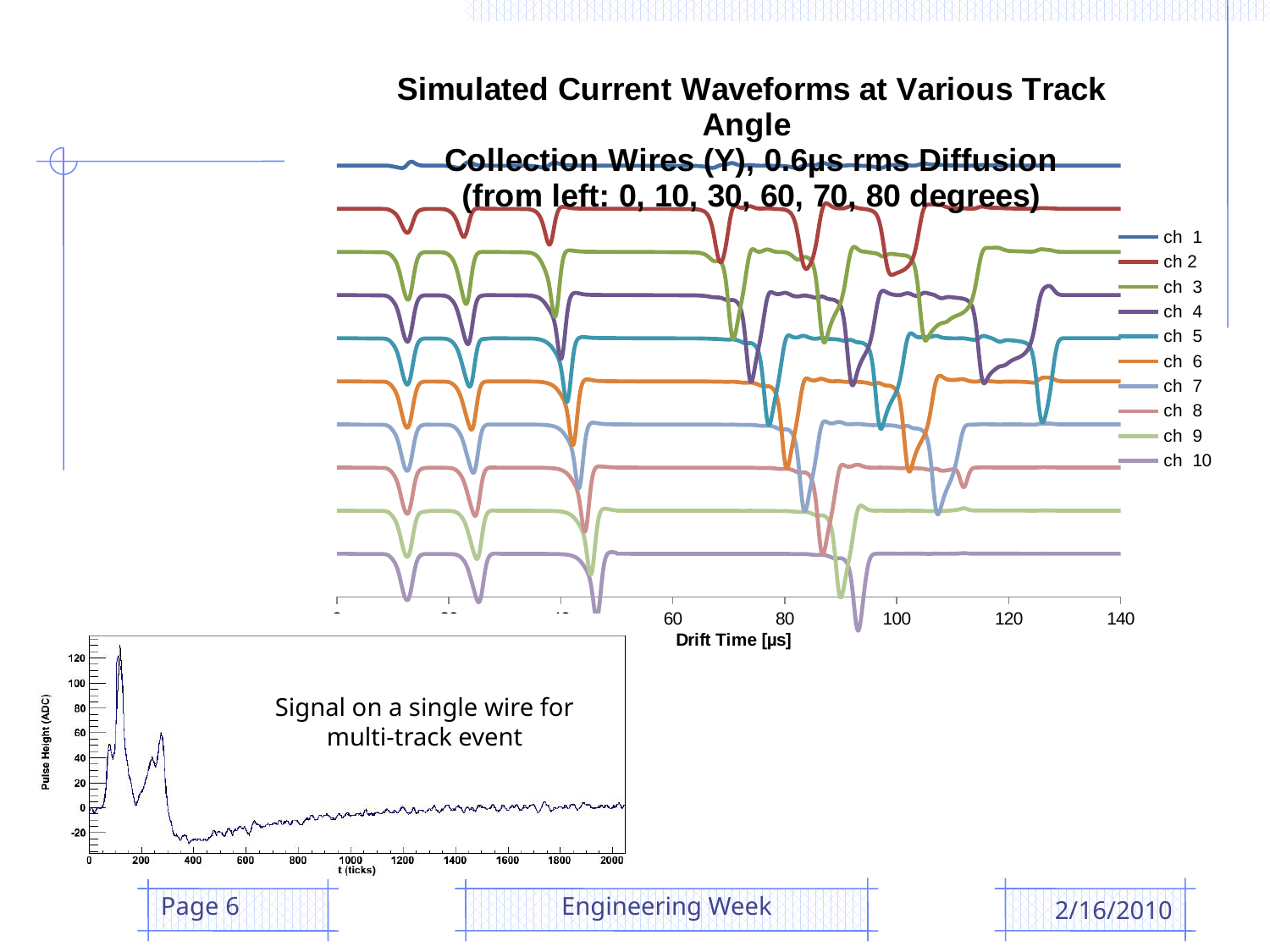
In the bottom-left chart 'Signal on a single wire for multi-track event', is the highest peak of the signal greater or less than 100? greater In the bottom-left chart 'Signal on a single wire for multi-track event', what is the y-axis label? Pulse Height (ADC) In the main waveform chart, what is the last series listed in the legend? ch 10 In the bottom-left chart 'Signal on a single wire for multi-track event', does the signal rise or fall between 400 and 2000 ticks? rise How many series does the legend of the main waveform chart list? 10 According to the subtitle of the main waveform chart, how many track angles are shown? 6 What is the highest tick value shown on the x axis of the bottom-left chart 'Signal on a single wire for multi-track event'? 2000 In the main waveform chart, what is the label of the x axis? Drift Time [µs] What kind of chart is the bottom-left chart 'Signal on a single wire for multi-track event'? line chart What is the highest tick value shown on the x axis of the main waveform chart? 140 What kind of chart is the main chart titled 'Simulated Current Waveforms at Various Track Angle'? line chart In the bottom-left chart 'Signal on a single wire for multi-track event', is the lowest point of the signal greater or less than 0? less